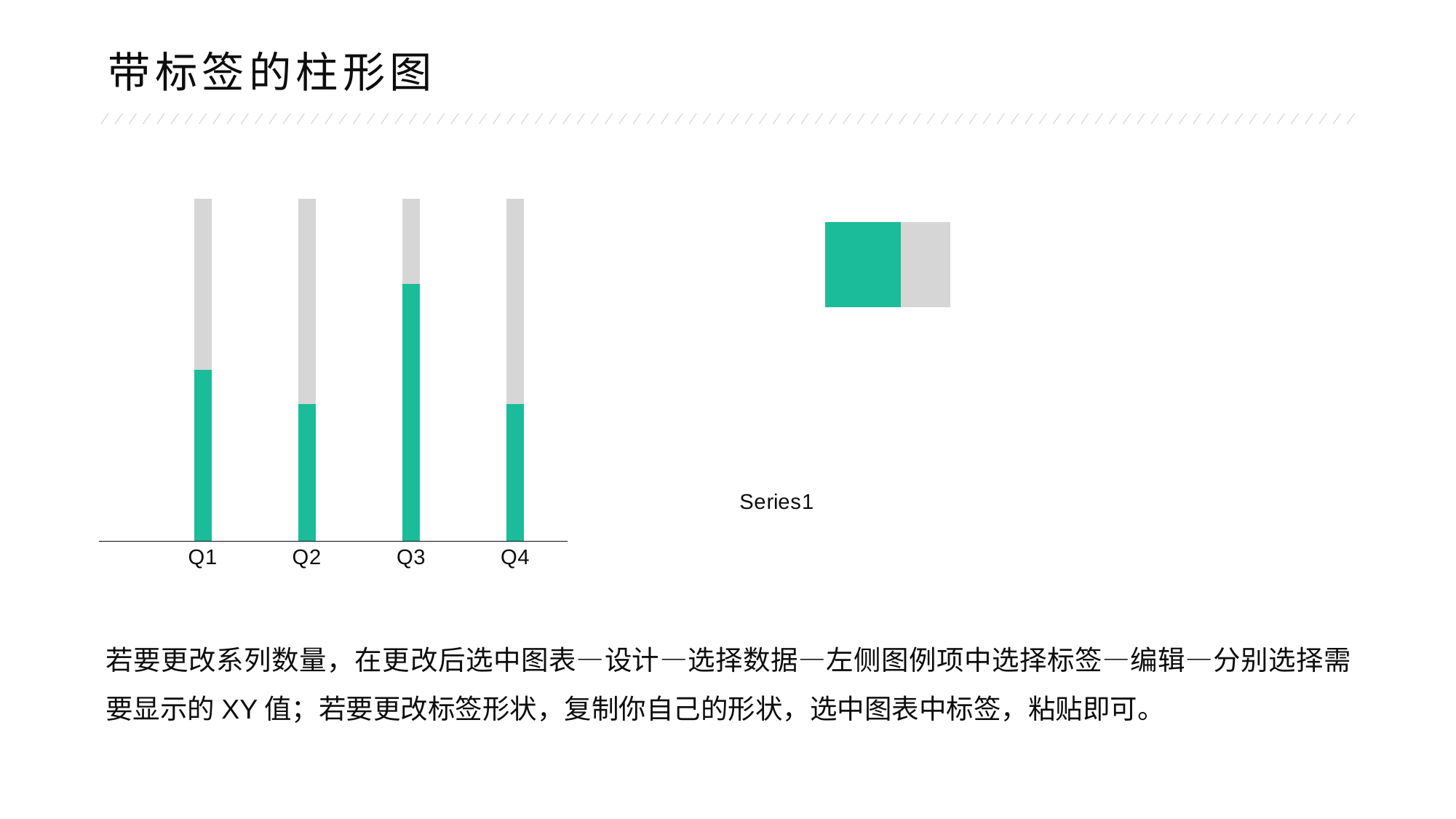
Is the green bar for Q1 taller or shorter than the green bar for Q2? taller Is the green bar for Q3 taller or shorter than the green bar for Q4? taller Which category has the tallest green bar in the bar chart? Q3 What kind of chart is shown on the left of the slide? bar chart Do the green bars rise steadily from Q1 to Q4? No How many categories are shown on the x axis of the bar chart? 4 What are the category labels on the x axis of the bar chart, from left to right? Q1, Q2, Q3, Q4 Is the green bar for Q1 taller or shorter than the green bar for Q3? shorter